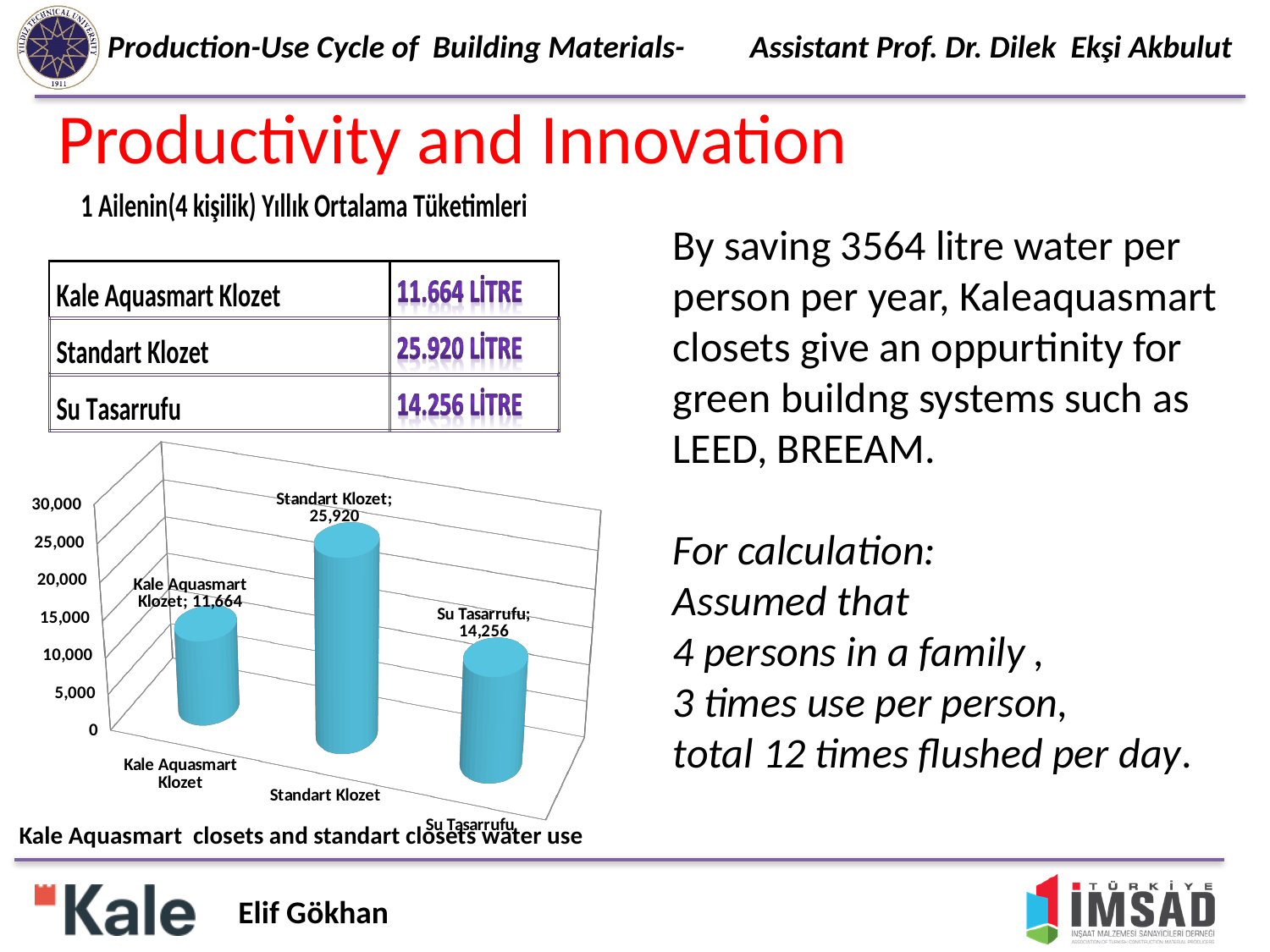
What is the value for Kale Aquasmart Klozet in the bar chart? 11,664 Which category has the highest value in the bar chart? Standart Klozet What is the highest value shown on the vertical axis of the bar chart? 30,000 Which is larger in the bar chart, the value for Su Tasarrufu or the value for Kale Aquasmart Klozet? Su Tasarrufu What is the value for Standart Klozet in the bar chart? 25,920 Which category has the lowest value in the bar chart? Kale Aquasmart Klozet What is the value for Su Tasarrufu in the bar chart? 14,256 What is the difference between the values for Su Tasarrufu and Kale Aquasmart Klozet in the bar chart? 2,592 How many categories are shown in the bar chart? 3 What kind of chart is shown on the slide? bar chart What is the difference between the values for Standart Klozet and Kale Aquasmart Klozet in the bar chart? 14,256 Is the value for Standart Klozet in the bar chart greater or less than 20,000? greater